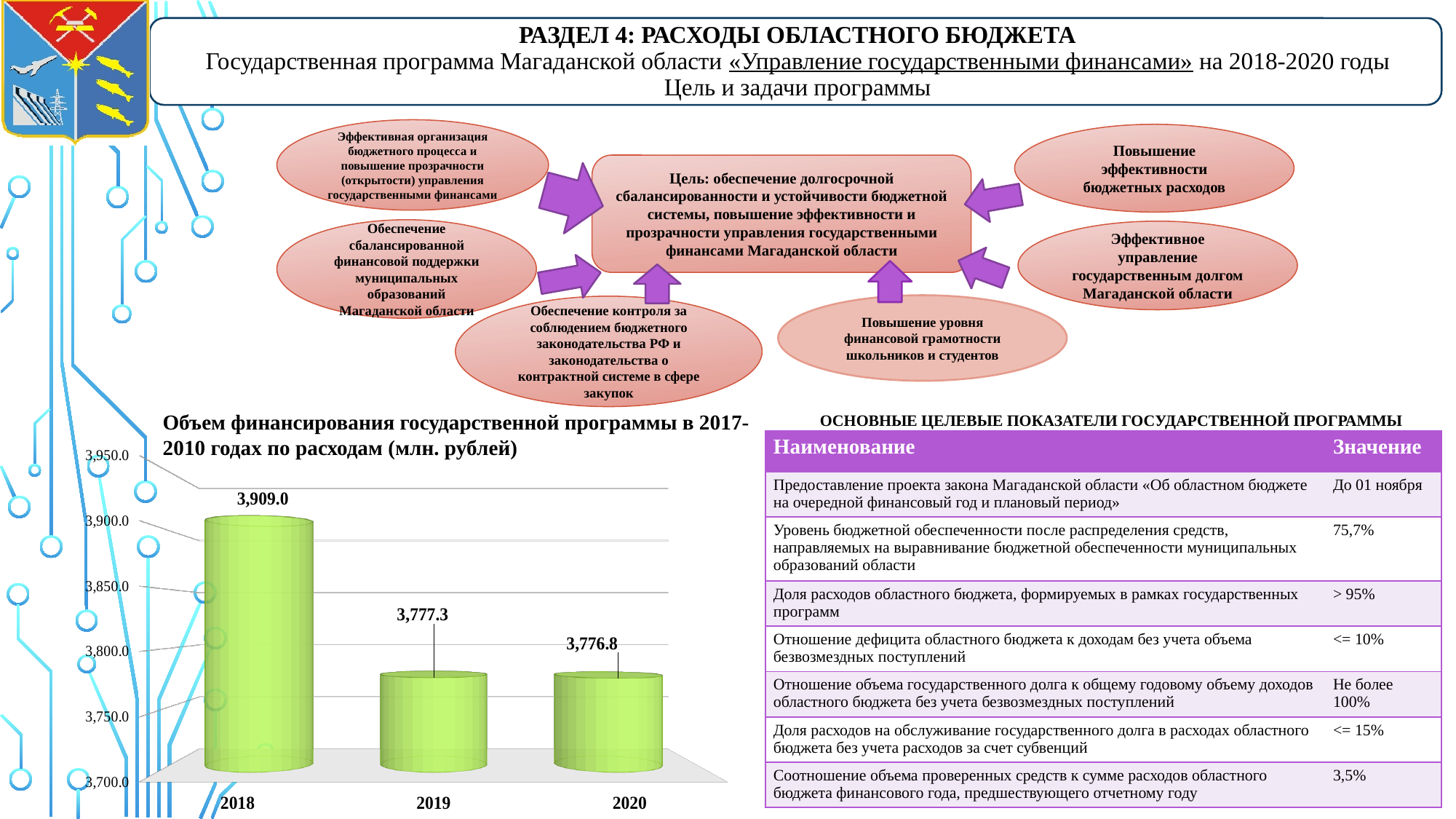
What kind of chart is used to show the programme funding volume? bar chart What is the difference between the values for 2018 and 2020 in the bar chart? 132.2 What is the value for 2020 in the bar chart? 3,776.8 Do the values in the bar chart rise or fall from 2018 to 2020? fall What is the difference between the values for 2018 and 2019 in the bar chart? 131.7 Is the value for 2019 in the bar chart greater or less than 3,800.0? less In what units are the values of the bar chart expressed, according to its title? млн. рублей How many years are shown in the bar chart? 3 What is the value for 2019 in the bar chart? 3,777.3 What is the value for 2018 in the bar chart? 3,909.0 Which year has the highest value in the bar chart? 2018 Which is larger in the bar chart, the value for 2018 or the value for 2019? 2018